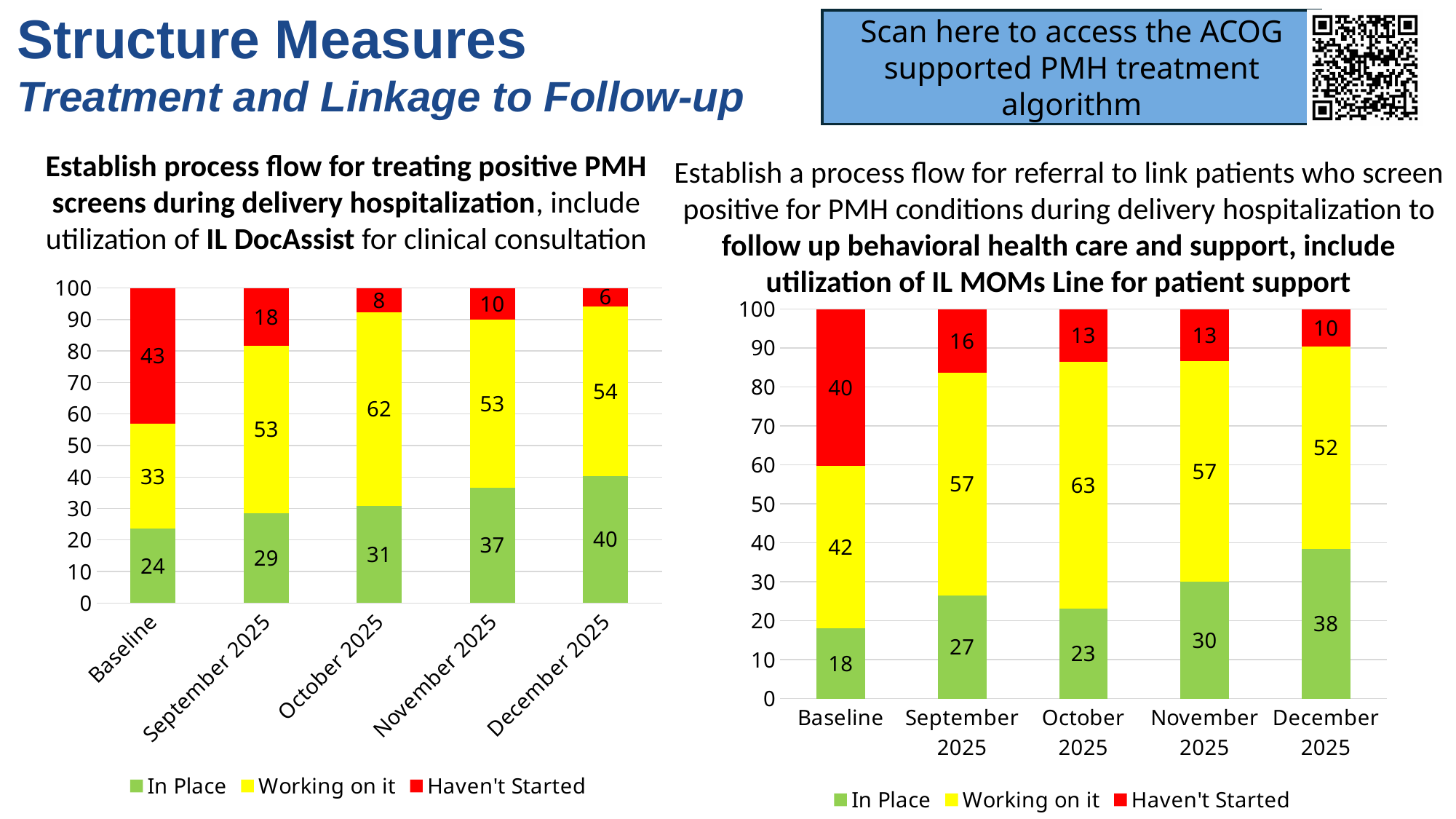
In the right chart, does the 'In Place' value rise or fall from November 2025 to December 2025? Rise In the right chart, what is the 'Working on it' value for October 2025? 63 In the right chart, which period has the lowest 'In Place' value? Baseline How many series does the legend of the left chart list? 3 What kind of chart is the left chart? Stacked bar chart In the left chart, what is the 'In Place' value for December 2025? 40 In the left chart, which period has the highest 'Haven't Started' value? Baseline In the right chart, which colour represents 'Haven't Started'? Red In the left chart, what is the difference between the 'In Place' values for December 2025 and Baseline? 16 In the right chart, is the 'Haven't Started' value larger for Baseline or for December 2025? Baseline How many periods are shown on the x axis of the right chart? 5 In the left chart, what is the total of the stacked bar for September 2025? 100